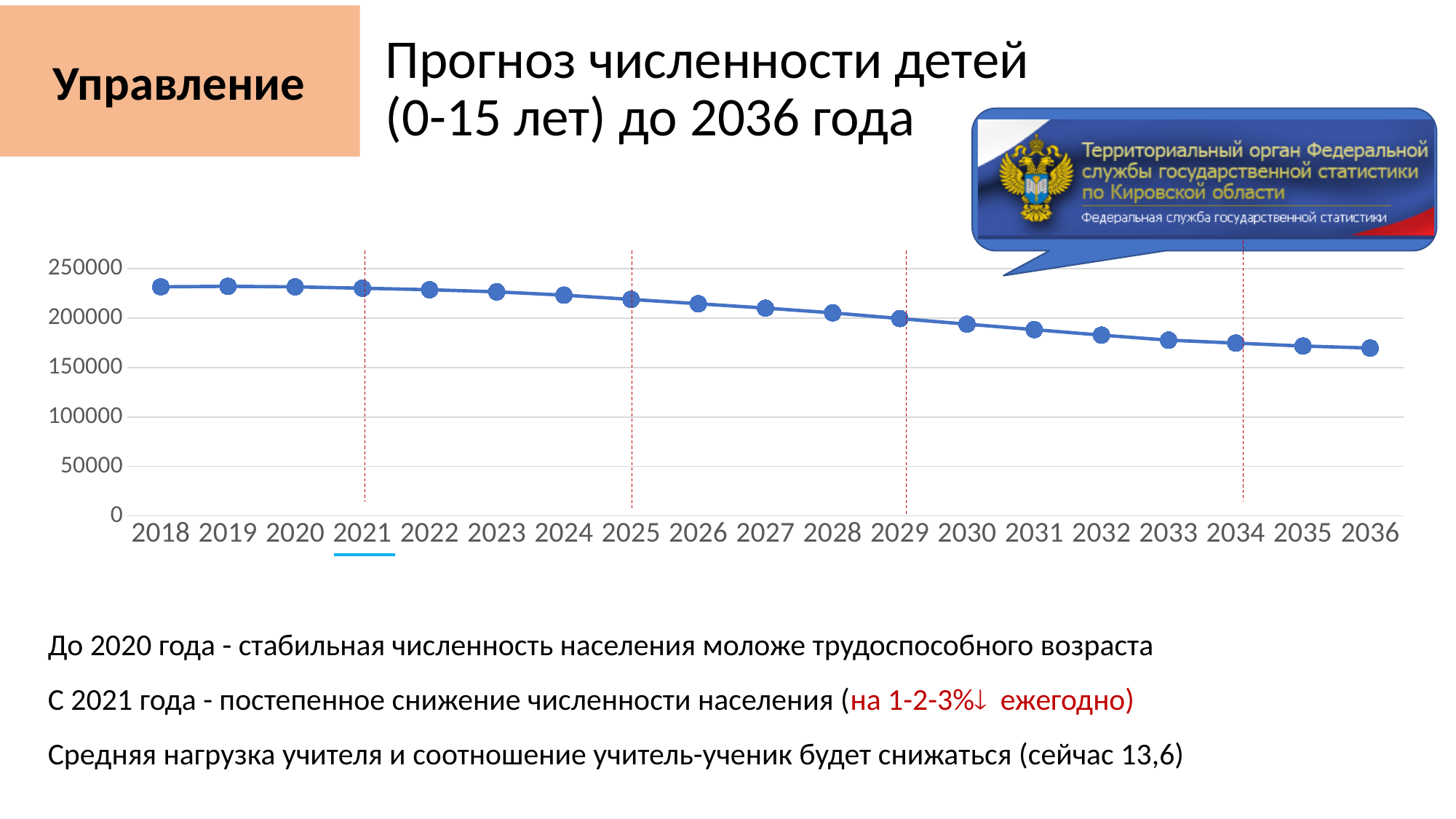
How many years (data points) are plotted on the x axis? 19 Is the value for 2036 greater or less than 150000? greater What kind of chart is shown on the slide? line chart What is the title of the chart on the slide? Прогноз численности детей (0-15 лет) до 2036 года Which is larger, the value for 2025 or the value for 2035? 2025 Do the values rise or fall from 2018 to 2036? fall Is the value for 2018 greater or less than 200000? greater Which is larger, the value for 2018 or the value for 2036? 2018 Is the value for 2031 greater or less than 200000? less Which year has the lowest value on the chart? 2036 What is the highest value shown on the y axis? 250000